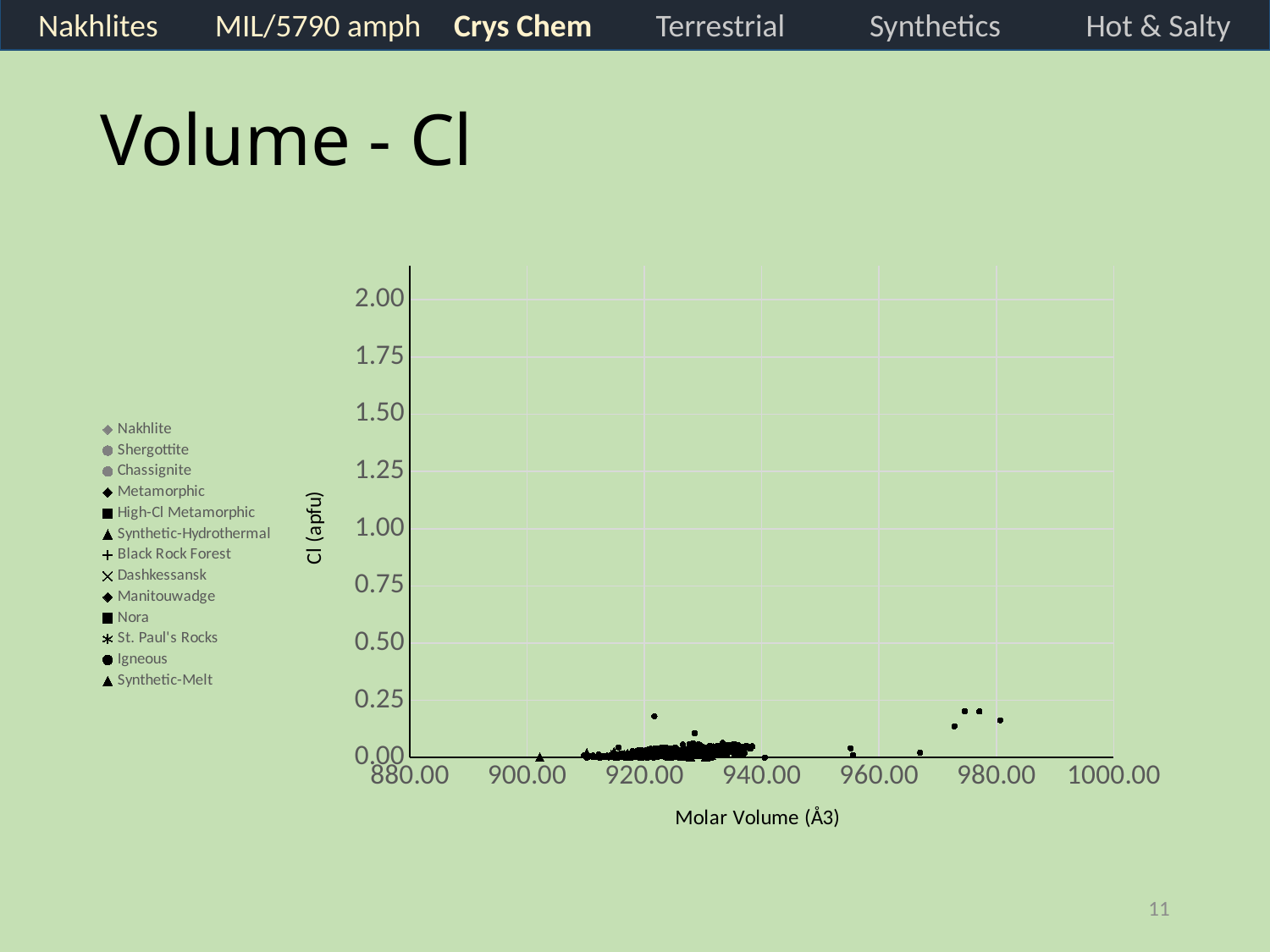
What is the maximum value shown on the y axis of the chart? 2.00 Is the molar volume of the isolated point plotted at the far left of the data greater or less than 920.00? less Are the points plotted near a molar volume of 980.00 greater or less than 0.25 Cl (apfu)? less Is the highest plotted Cl (apfu) value greater or less than 1.00? less What kind of chart is shown on the slide? scatter chart What is the label of the x axis of the chart? Molar Volume (Å3) What is the title of the chart on the slide? Volume - Cl How many series does the chart's legend list? 13